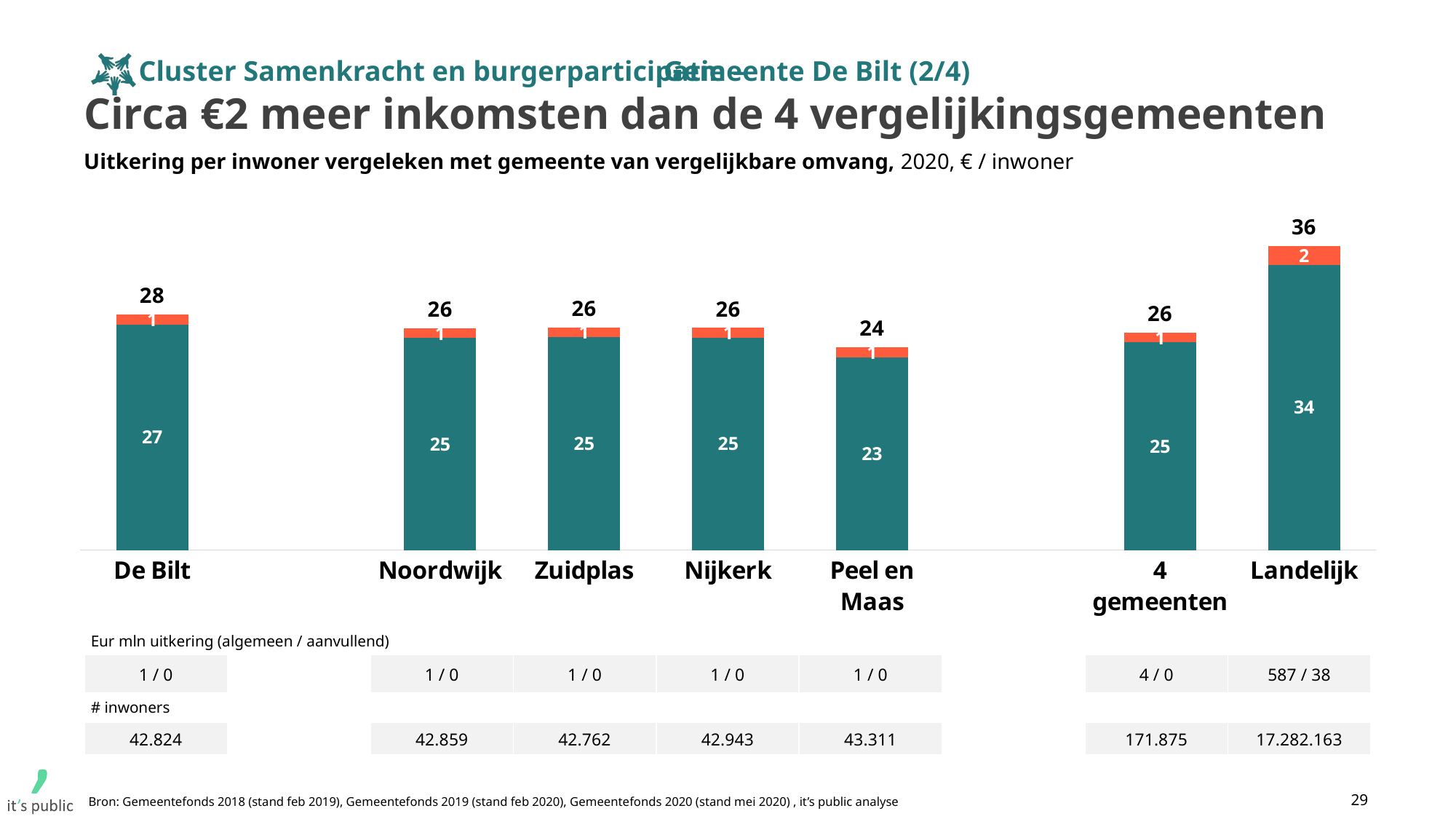
What is the difference between the total for De Bilt and the total for 4 gemeenten? 2 How many categories are shown on the x axis of the chart? 7 Which is larger, the total for De Bilt or the total for Nijkerk? De Bilt What is the value of the orange (upper) segment for Landelijk? 2 What kind of chart is shown on the slide? Stacked bar chart What is the total value shown above the bar for Peel en Maas? 24 Which category has the lowest total value? Peel en Maas What is the unit stated in the chart subtitle? € / inwoner What is the total value shown above the bar for De Bilt? 28 Which category has the highest total value? Landelijk What is the value of the teal (lower) segment for Landelijk? 34 What is the difference between the total for Landelijk and the total for De Bilt? 8